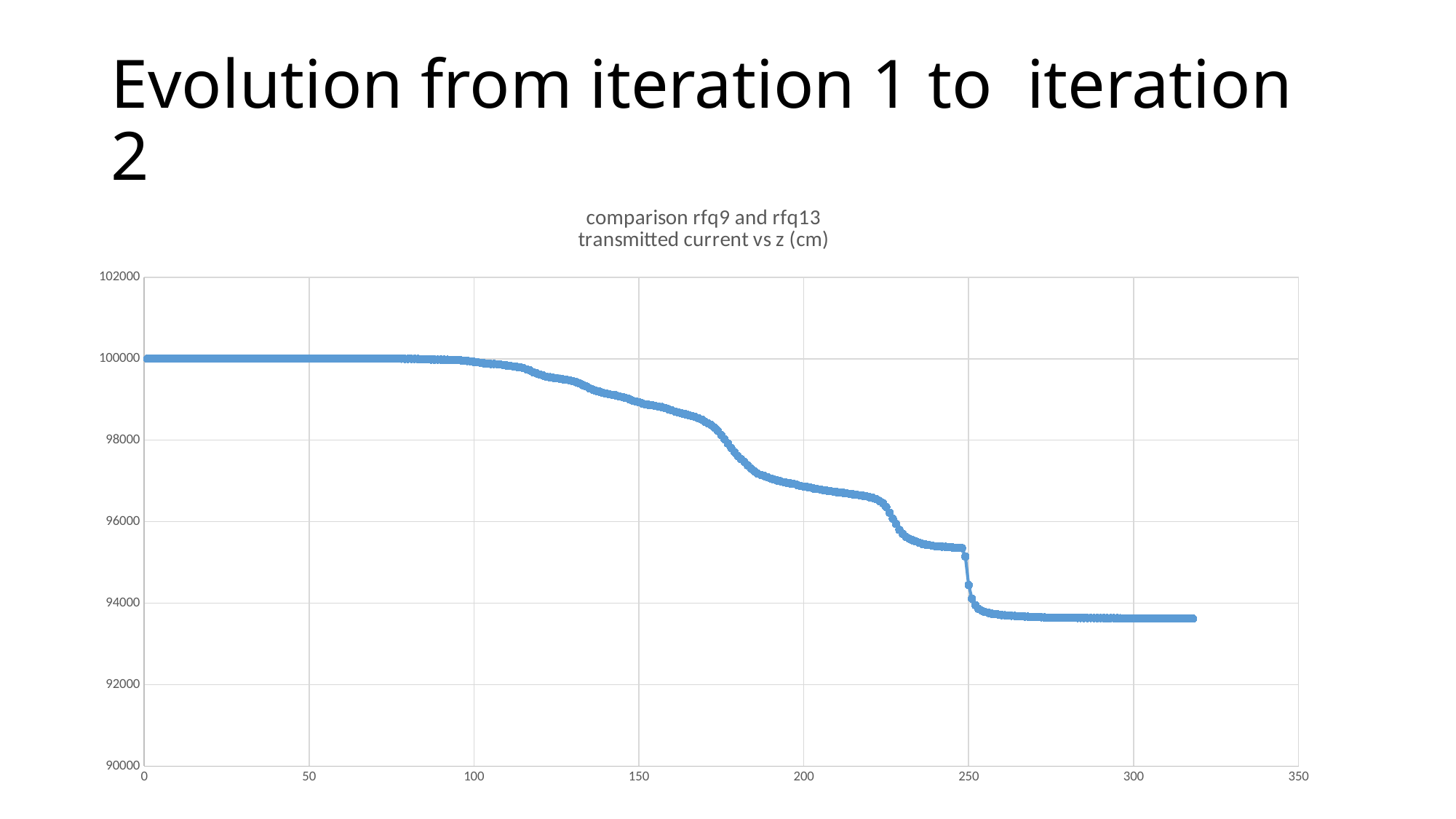
Is the value at z = 275 greater or less than 92000? greater What is the title of the chart? comparison rfq9 and rfq13 transmitted current vs z (cm) Is the value at z = 300 greater or less than 94000? less Is the value at z = 200 greater or less than 96000? greater Do the plotted values rise or fall as z increases along the x axis? fall What kind of chart is shown on the slide? scatter chart What is the highest value shown on the y axis? 102000